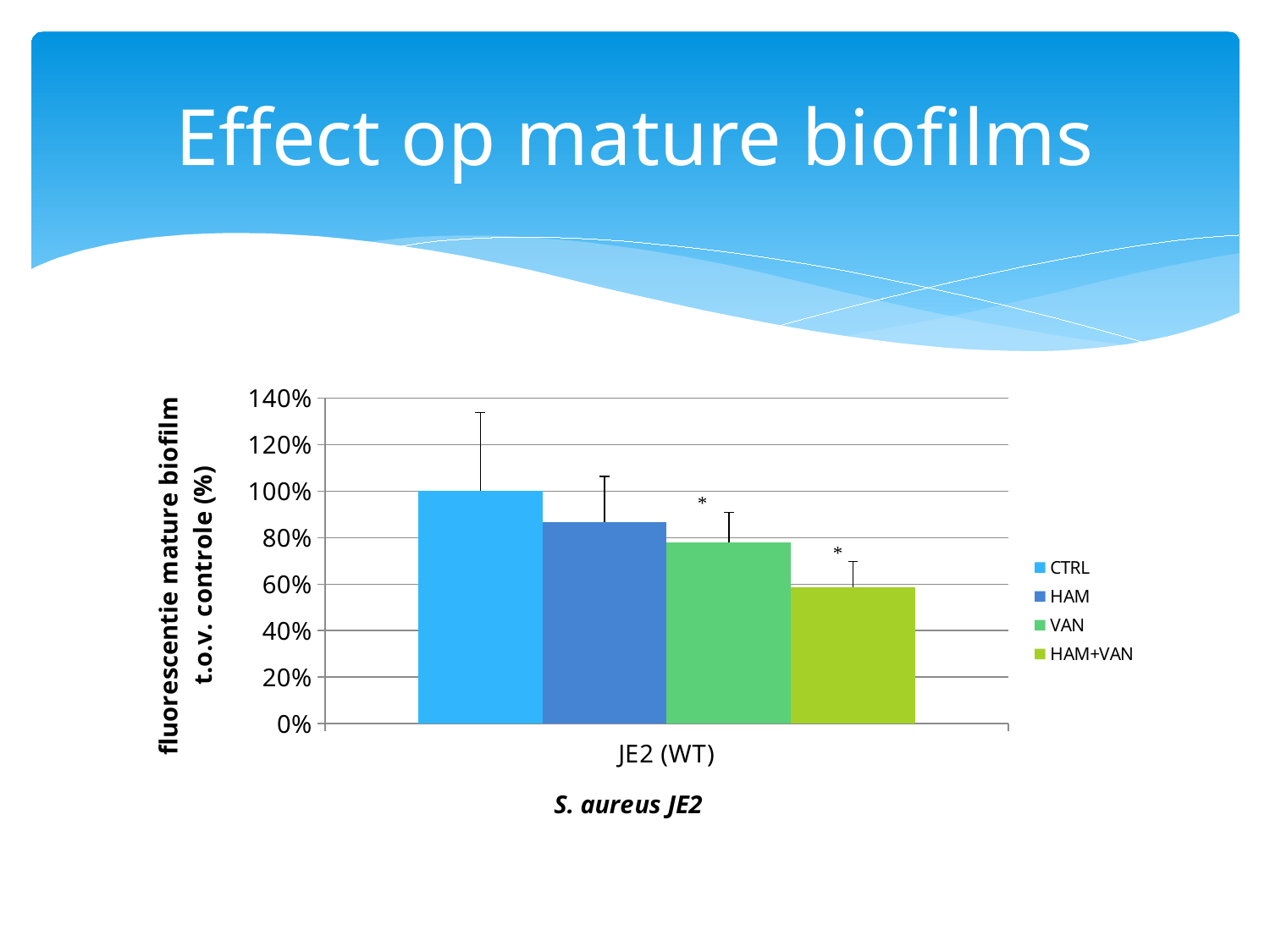
Which series has the highest value? CTRL What is the value for CTRL? 100% Is the value for HAM greater or less than 80%? greater Which series has the lowest value? HAM+VAN Which is larger, the value for HAM or the value for VAN? HAM What is the title of the y axis? fluorescentie mature biofilm t.o.v. controle (%) How many series does the legend list? 4 Is the value for VAN greater or less than 60%? greater What kind of chart is shown on the slide? bar chart What is the label of the category on the x axis? JE2 (WT) How many categories are shown on the x axis? 1